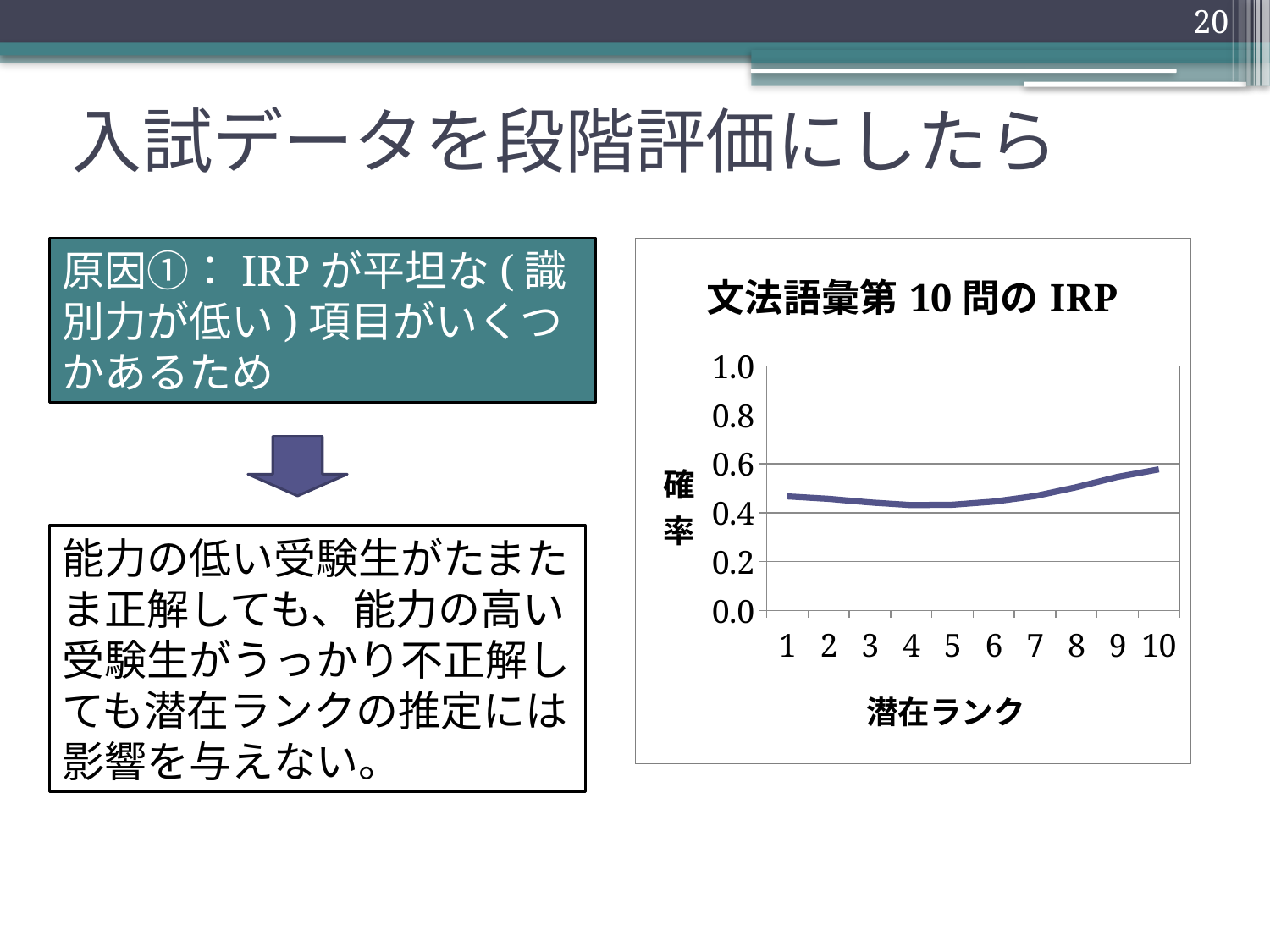
What kind of chart is shown on the slide? line chart Is the 確率 at 潜在ランク 10 greater or less than 0.4? greater Is the 確率 at 潜在ランク 5 greater or less than 0.2? greater Does the 確率 rise or fall from 潜在ランク 5 to 潜在ランク 10? rise Is the 確率 at 潜在ランク 5 greater or less than 0.6? less How many 潜在ランク values are plotted along the x axis? 10 What is the label of the x axis of the chart? 潜在ランク At which 潜在ランク is the 確率 highest? 10 What is the title of the chart? 文法語彙第10問のIRP Which has the larger 確率, 潜在ランク 2 or 潜在ランク 9? 潜在ランク 9 Which has the larger 確率, 潜在ランク 1 or 潜在ランク 10? 潜在ランク 10